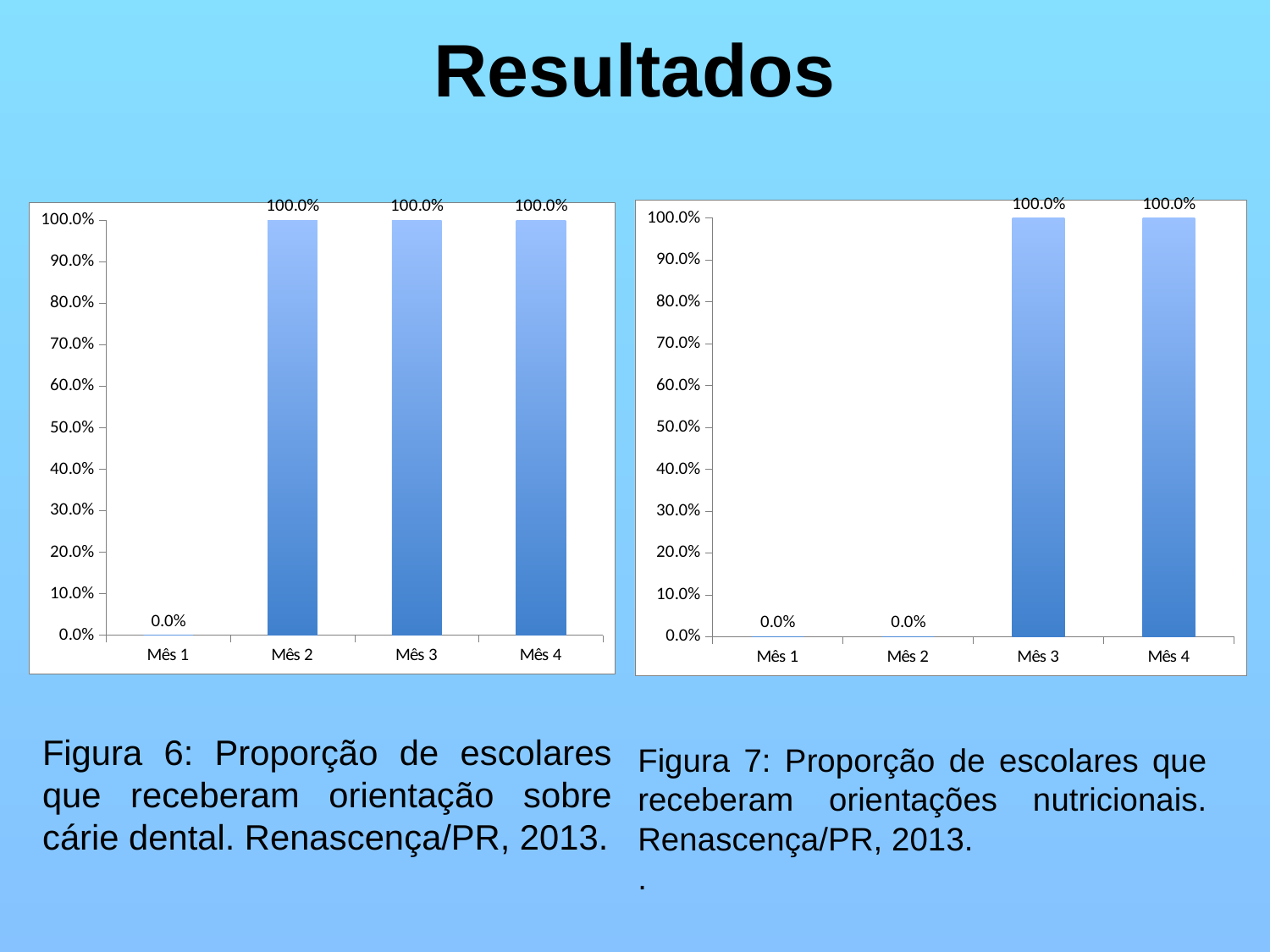
In the right chart (Figura 7), what is the value for Mês 2? 0.0% In the left chart (Figura 6), what is the value for Mês 1? 0.0% In the right chart (Figura 7), what is the difference between the values for Mês 4 and Mês 2? 100.0% In the right chart (Figura 7), what is the value for Mês 3? 100.0% In the right chart (Figura 7), which month has the lowest value, Mês 1 or Mês 3? Mês 1 What kind of chart is the right chart (Figura 7)? Bar chart How many categories (months) are shown in the left chart (Figura 6)? 4 In the left chart (Figura 6), what is the difference between the values for Mês 2 and Mês 1? 100.0% In the left chart (Figura 6), what is the value for Mês 2? 100.0% In the left chart (Figura 6), which month has the lowest value? Mês 1 In the right chart (Figura 7), how many months have a value of 0.0%? 2 In the right chart (Figura 7), do the values rise or fall from Mês 2 to Mês 3? Rise